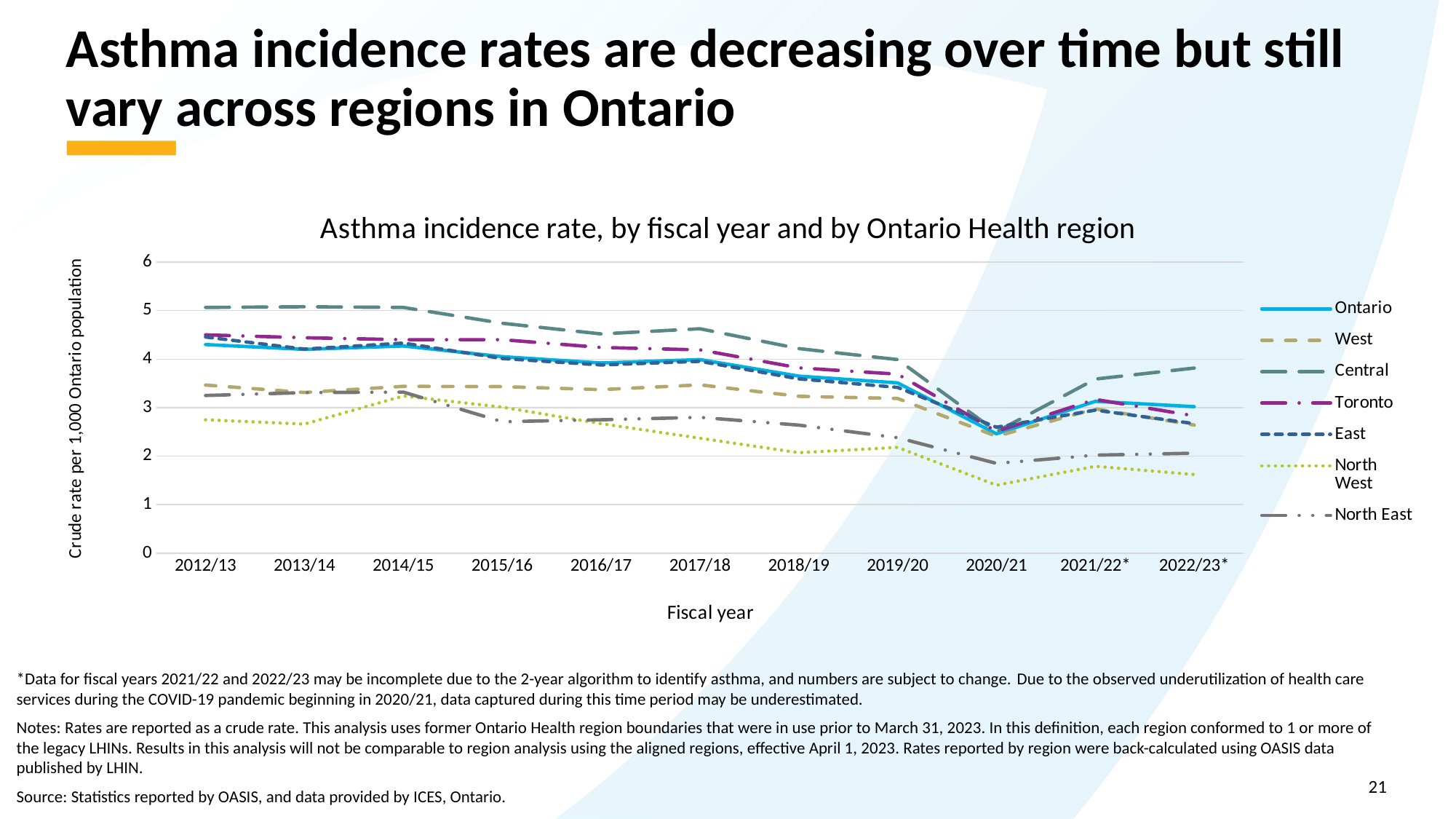
What kind of chart is shown on the slide? Line chart Which region has the lowest asthma incidence rate in 2022/23? North West Is the value for North West in 2020/21 greater or less than 2? less How many fiscal years are shown on the x axis? 11 Is the value for Central in 2012/13 greater or less than 4? greater How many series does the legend list? 7 Does the Ontario line rise or fall overall from 2012/13 to 2022/23? Fall Which region has the highest asthma incidence rate in 2012/13? Central Is the value for Central in 2022/23 greater or less than 4? less In 2019/20, which is larger: the value for Toronto or the value for North West? Toronto What is the title of the chart? Asthma incidence rate, by fiscal year and by Ontario Health region